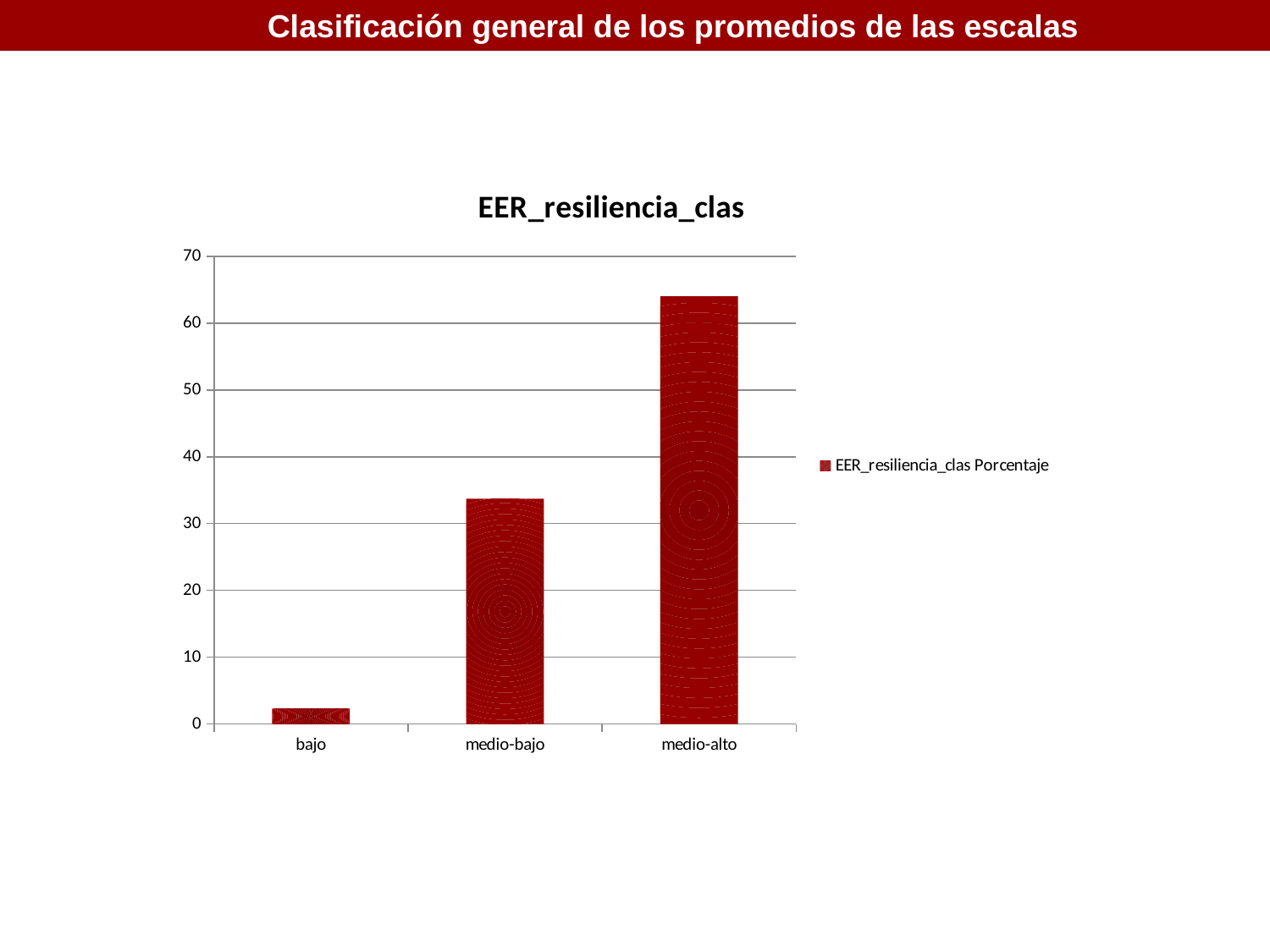
Which category has the lowest value? bajo Do the values rise or fall from left to right along the x axis? rise How many categories are shown on the x axis? 3 Which is larger, the value for medio-bajo or the value for medio-alto? medio-alto How many series does the legend list? 1 What kind of chart is shown on the slide? bar chart Is the value for bajo greater or less than 10? less Which category has the highest value? medio-alto What is the name of the series in the legend? EER_resiliencia_clas Porcentaje What is the title of the chart? EER_resiliencia_clas Is the value for medio-alto greater or less than 60? greater Is the value for medio-bajo greater or less than 30? greater